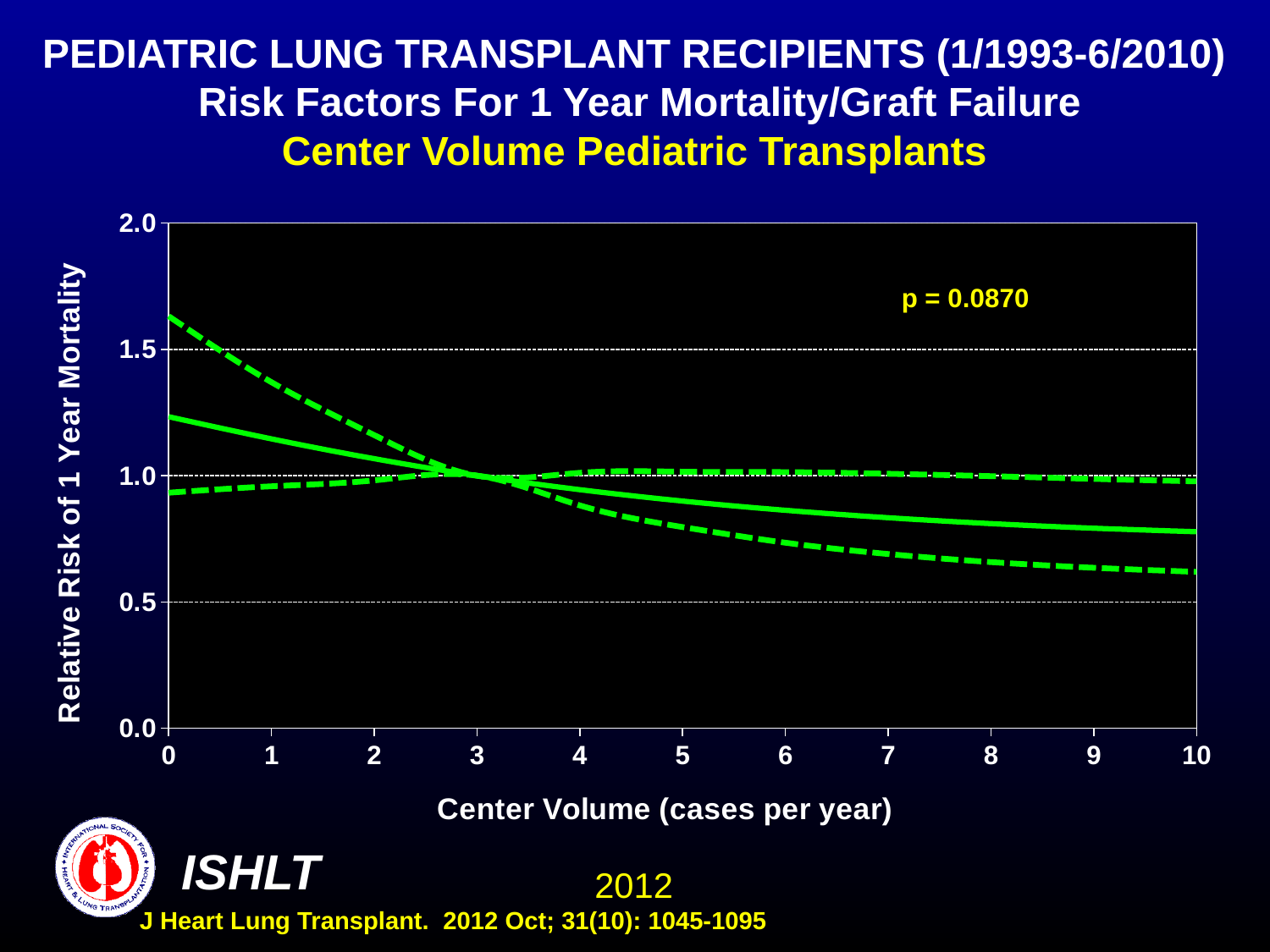
Is the value of the upper dashed line at a center volume of 0 cases per year greater or less than 1.5? greater Is the value of the lower dashed line at a center volume of 0 cases per year greater or less than 1.0? less What p-value is printed on the chart? p = 0.0870 Is the value of the lower dashed line at a center volume of 10 cases per year greater or less than 0.5? greater What is the highest value shown on the y axis? 2.0 How many lines are plotted on the chart? 3 What is the label of the x axis? Center Volume (cases per year) What kind of chart is shown on the slide? line chart Does the solid line for relative risk of 1 year mortality rise or fall as center volume increases from 0 to 10 cases per year? fall Is the solid line's value at a center volume of 0 larger or smaller than its value at a center volume of 10? larger